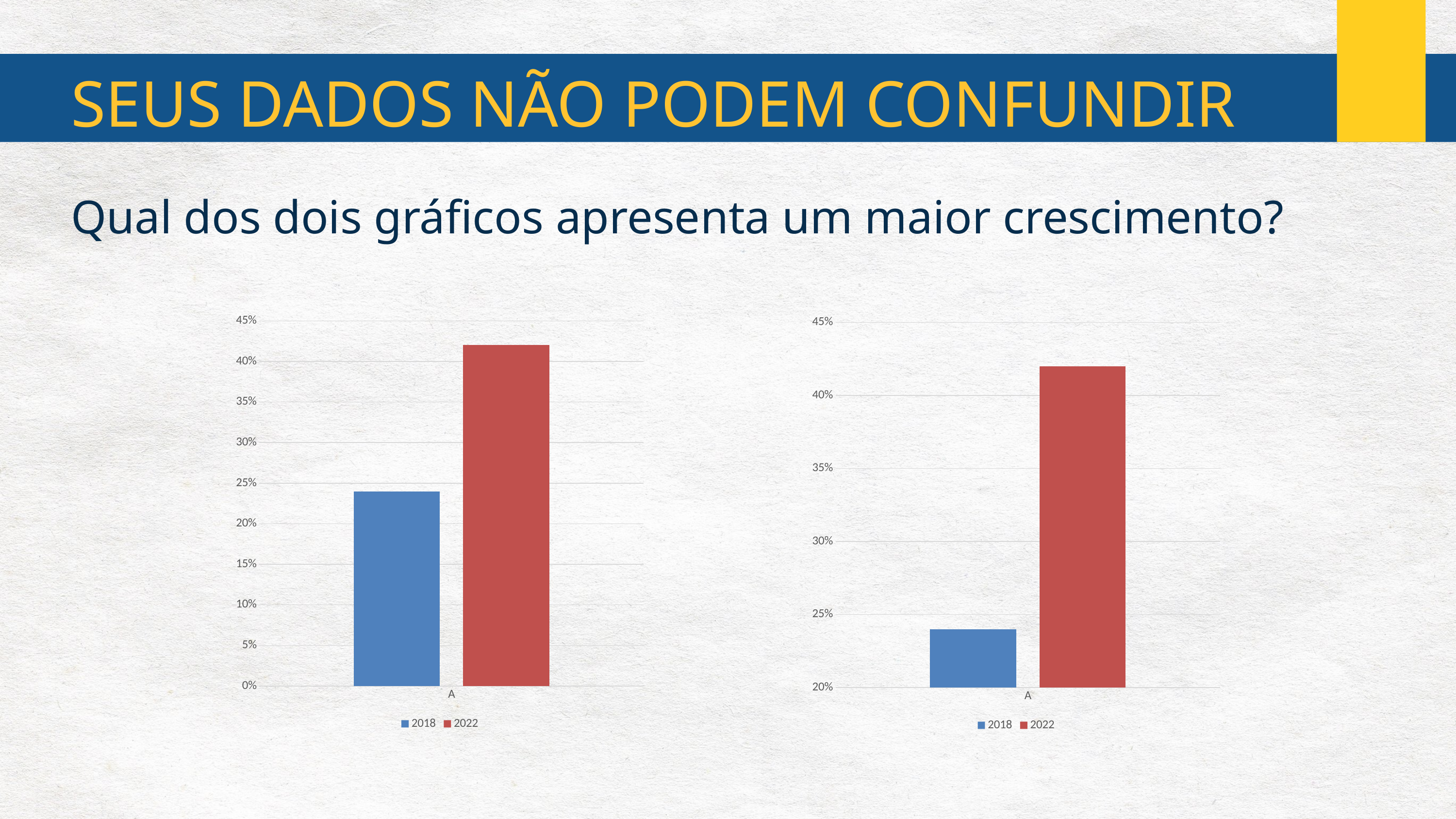
In the chart on the left, how many series does the legend list? 2 In the chart on the left, is the value for 2018 greater or less than 25%? less In the chart on the right, which series has the shorter bar for category A, 2018 or 2022? 2018 What is the lowest value shown on the y axis of the chart on the right? 20% In the chart on the right, is the value for 2022 greater or less than 40%? greater What kind of chart is the chart on the left of the slide? bar chart In the chart on the left, which series has the taller bar for category A, 2018 or 2022? 2022 In the chart on the right, how many categories are shown on the x axis? 1 What kind of chart is the chart on the right of the slide? bar chart In the chart on the right, is the value for 2018 greater or less than 25%? less In the chart on the left, what colour is the bar for the 2022 series? red